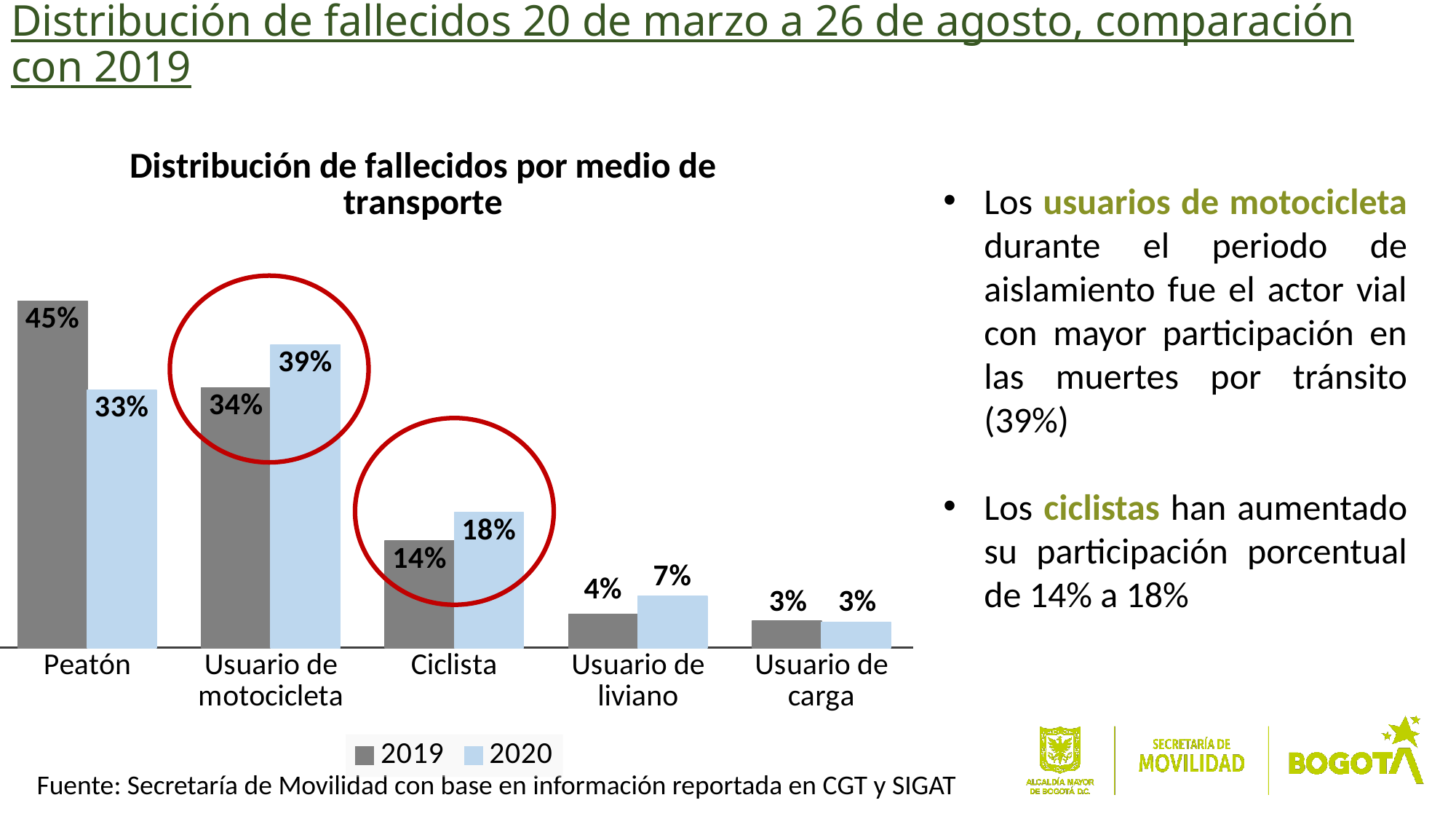
How many series does the legend list? 2 What is the difference between the 2019 and 2020 values for Peatón? 12% What is the 2019 value for Peatón? 45% How many categories are shown on the x axis? 5 Which category has the highest 2019 value? Peatón Which category has the highest 2020 value? Usuario de motocicleta Which is larger for Usuario de motocicleta, the 2019 value or the 2020 value? 2020 What is the difference between the 2020 and 2019 values for Ciclista? 4% What kind of chart is shown on the slide? Bar chart What is the 2019 value for Usuario de liviano? 4% What is the 2020 value for Ciclista? 18% What is the 2020 value for Usuario de motocicleta? 39%